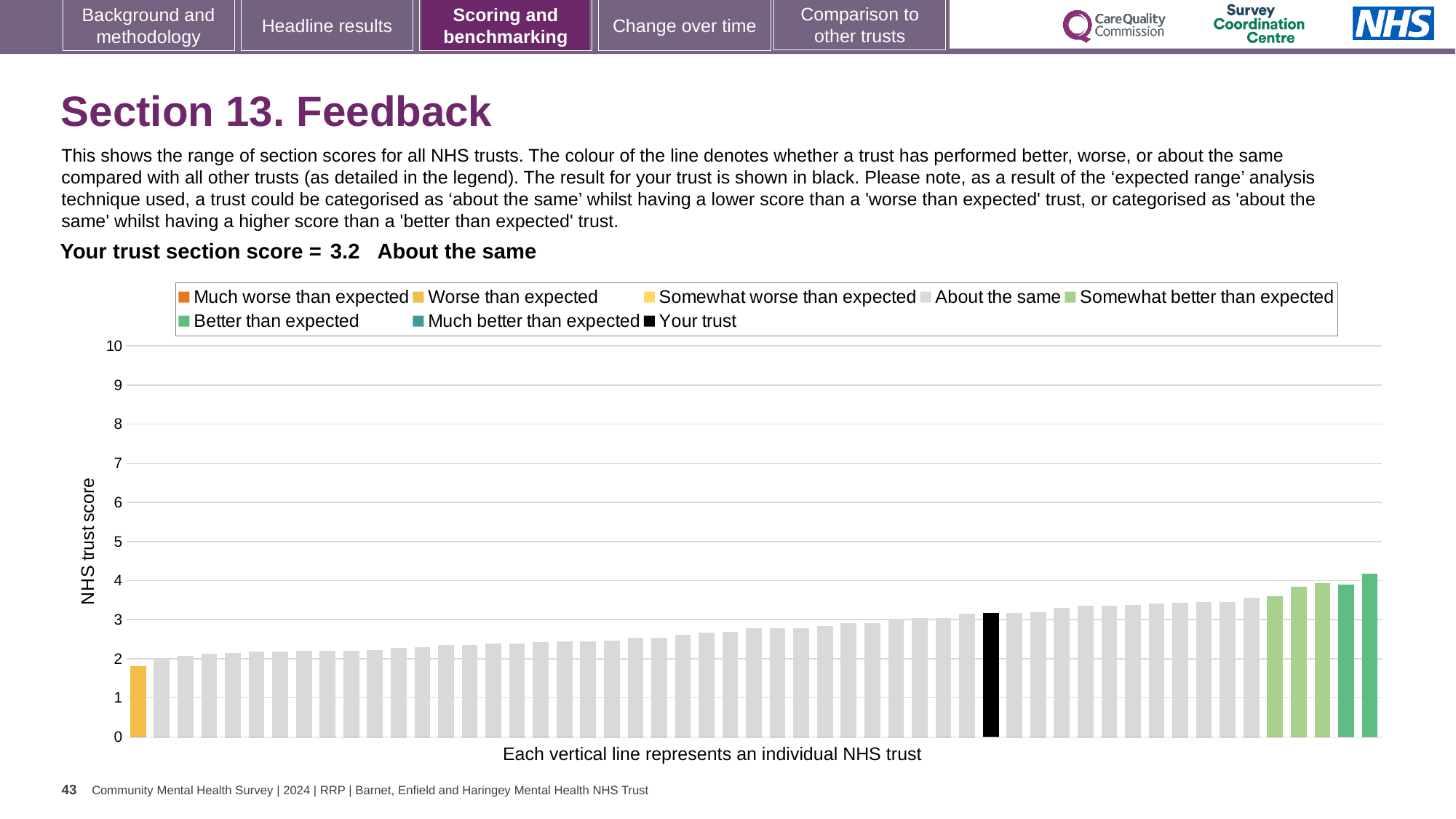
Do the bar values rise or fall from left to right along the x axis? rise What kind of chart is shown on the slide? bar chart How many bars are coloured as 'Worse than expected'? 1 What is the section score for Your trust? 3.2 Is the value for Your trust greater or less than 4? less Which category is Your trust placed in according to the slide? About the same What colour is the bar representing Your trust? black What is the label on the y axis of the chart? NHS trust score How many entries does the chart legend list? 8 Is the value of the highest bar greater or less than 4? greater Is the value of the lowest bar greater or less than 3? less